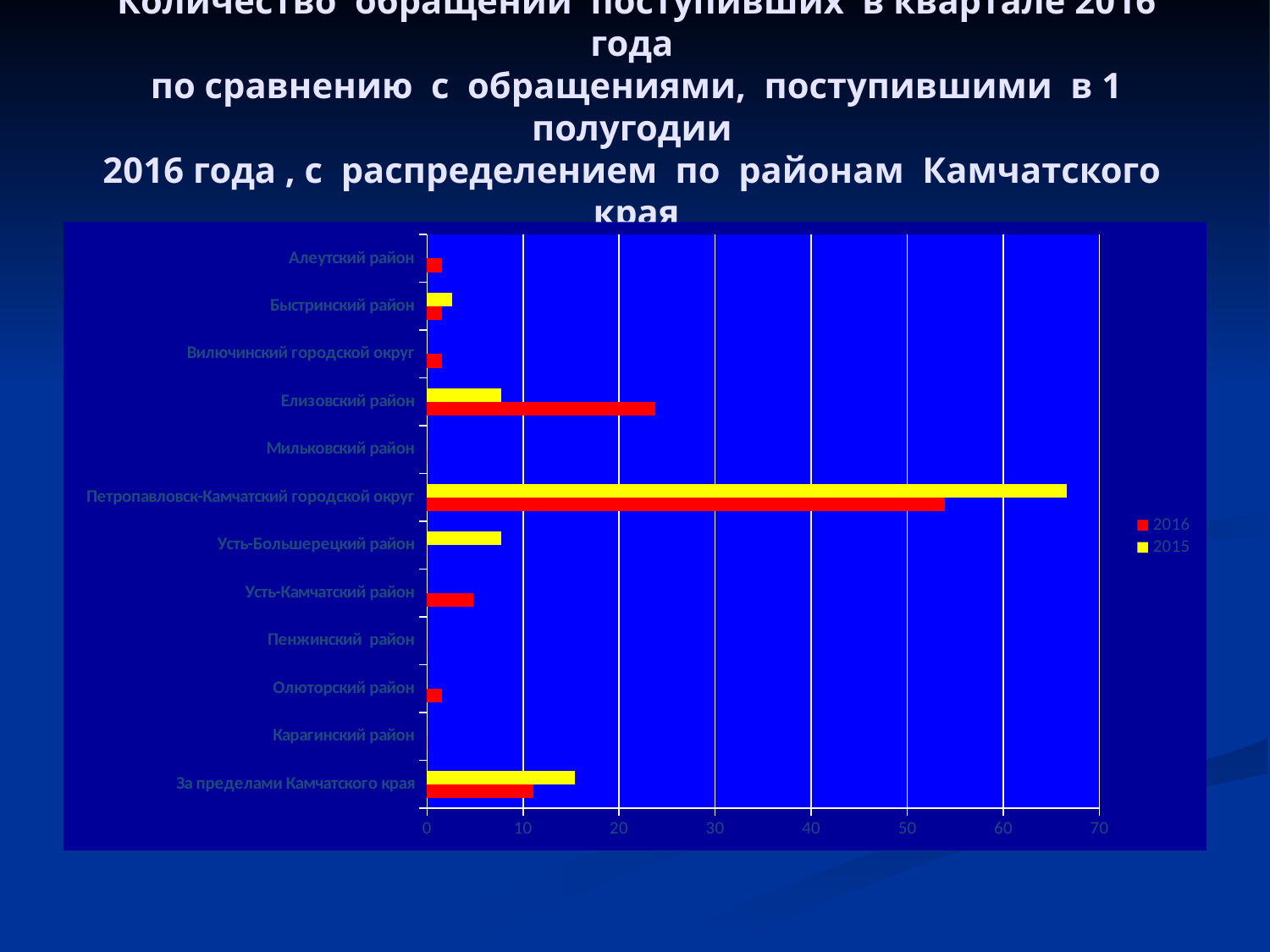
How many districts (categories) are listed on the vertical axis of the chart? 12 Which colour represents the 2015 series in the legend? yellow Is the 2016 value for Петропавловск-Камчатский городской округ greater or less than 60? less Is the 2016 value for Елизовский район greater or less than 20? greater How many series does the legend list? 2 Is the 2015 value for За пределами Камчатского края greater or less than 10? greater What kind of chart is shown on the slide? bar chart For Петропавловск-Камчатский городской округ, which series has the larger value, 2016 or 2015? 2015 Which district has the highest value for 2015? Петропавловск-Камчатский городской округ For Елизовский район, which series has the larger value, 2016 or 2015? 2016 Which district has the highest value for 2016? Петропавловск-Камчатский городской округ